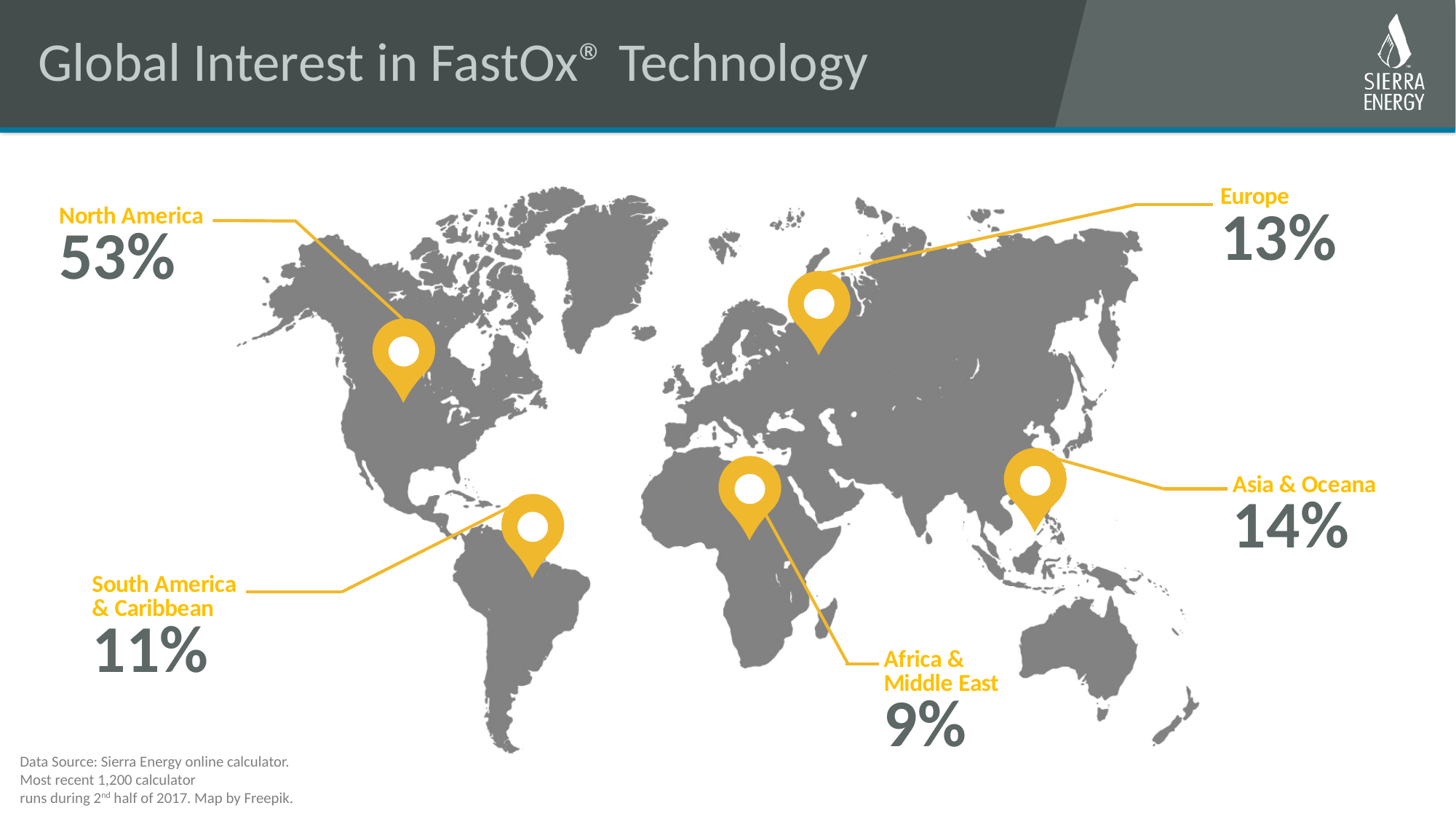
What percentage of global interest in FastOx Technology comes from North America? 53% Which has a larger share, Europe or Asia & Oceana? Asia & Oceana What percentage is shown for Europe on the map? 13% What is the difference in percentage points between North America and Europe? 40 What is the difference in percentage points between Asia & Oceana and Africa & Middle East? 5 How many regions are labeled with percentages on the map? 5 What percentage is shown for Africa & Middle East? 9% Which region has the lowest share of interest in FastOx Technology? Africa & Middle East What percentage is shown for South America & Caribbean? 11% What is the title of the chart on this slide? Global Interest in FastOx Technology Which region has the highest share of interest in FastOx Technology? North America What percentage is shown for Asia & Oceana? 14%